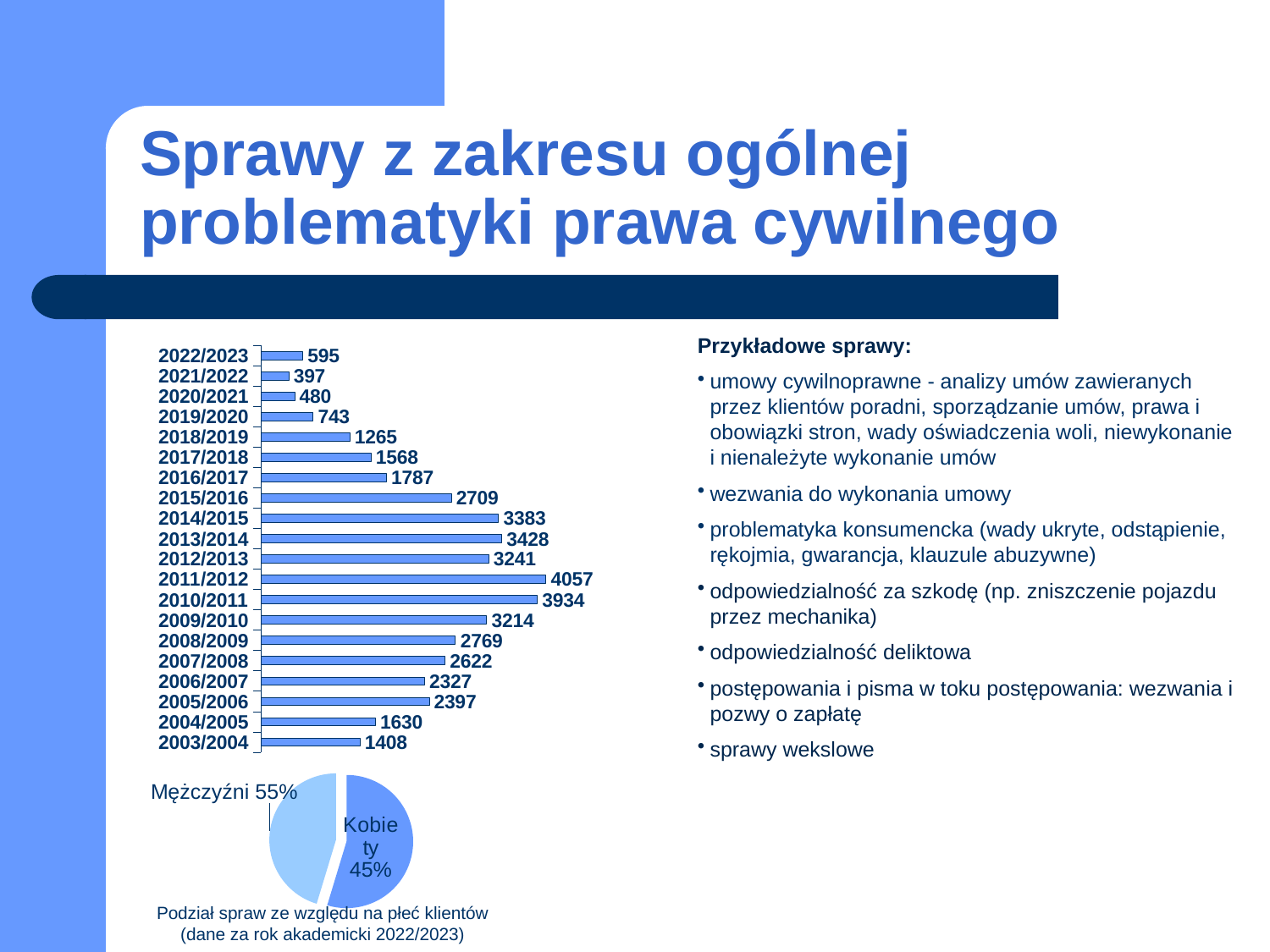
In the bar chart on the left, which academic year has the highest value? 2011/2012 What is the caption of the pie chart at the bottom left of the slide? Podział spraw ze względu na płeć klientów (dane za rok akademicki 2022/2023) What type of chart is the upper chart on the left of the slide? Bar chart In the pie chart at the bottom left, what share is labelled Mężczyźni? 55% In the bar chart on the left, which is larger: the value for 2014/2015 or the value for 2013/2014? 2013/2014 In the pie chart at the bottom left, what share is labelled Kobiety? 45% In the bar chart on the left, what is the difference between the values for 2011/2012 and 2010/2011? 123 In the bar chart on the left, how many academic years are shown? 20 In the bar chart on the left, what is the value for 2003/2004? 1408 In the bar chart on the left, which academic year has the lowest value? 2021/2022 In the bar chart on the left, what is the value for 2011/2012? 4057 In the bar chart on the left, what is the value for 2022/2023? 595